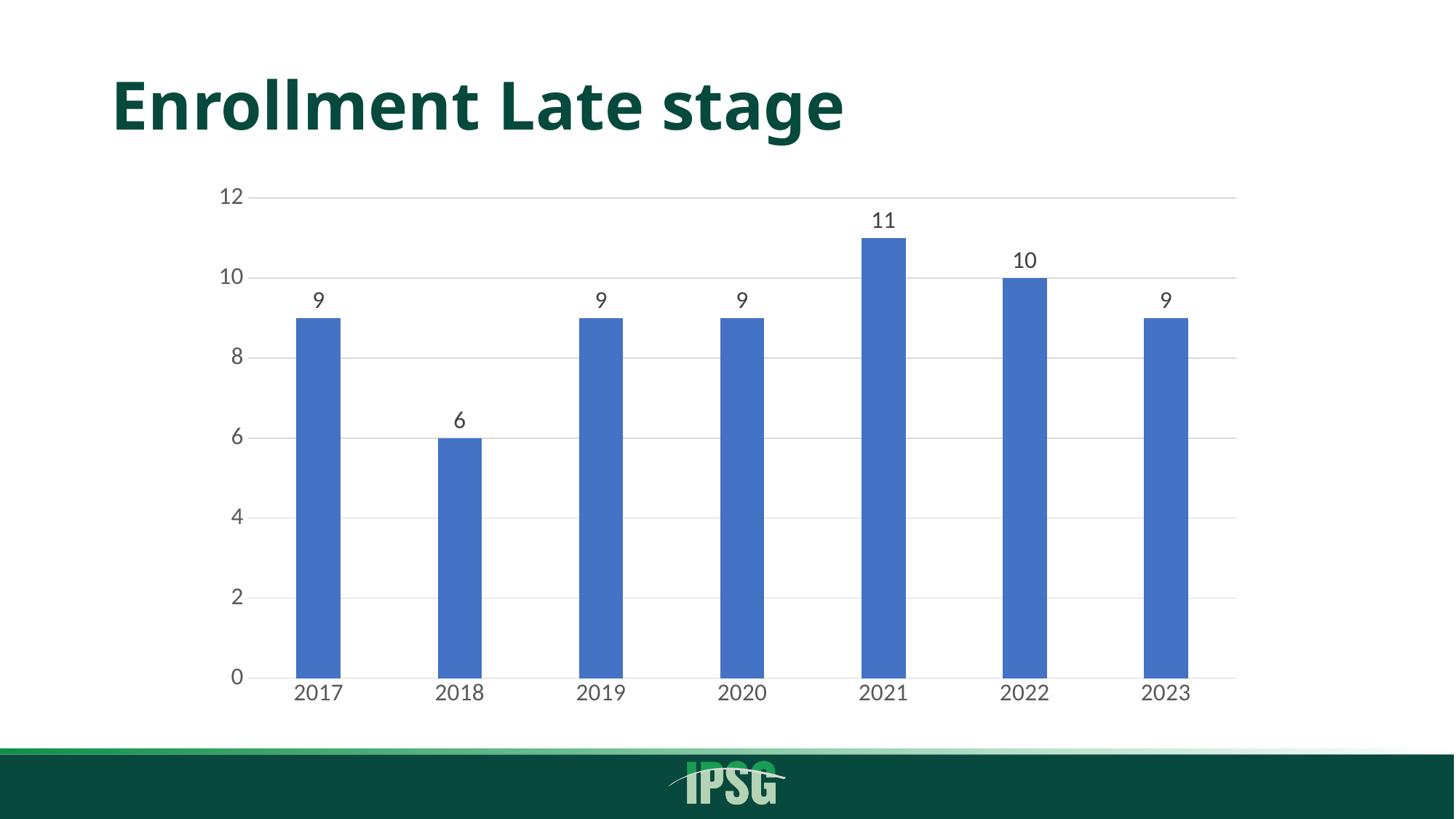
What is the value for 2018? 6 What is the value for 2021? 11 What is the value for 2022? 10 Which year has the highest value? 2021 How many years are shown on the x axis? 7 Which year has the lowest value? 2018 What is the title of the slide? Enrollment Late stage What kind of chart is shown on the slide? Bar chart What is the value for 2023? 9 What is the difference between the values for 2021 and 2018? 5 Which is larger, the value for 2018 or the value for 2019? 2019 What is the difference between the values for 2022 and 2023? 1